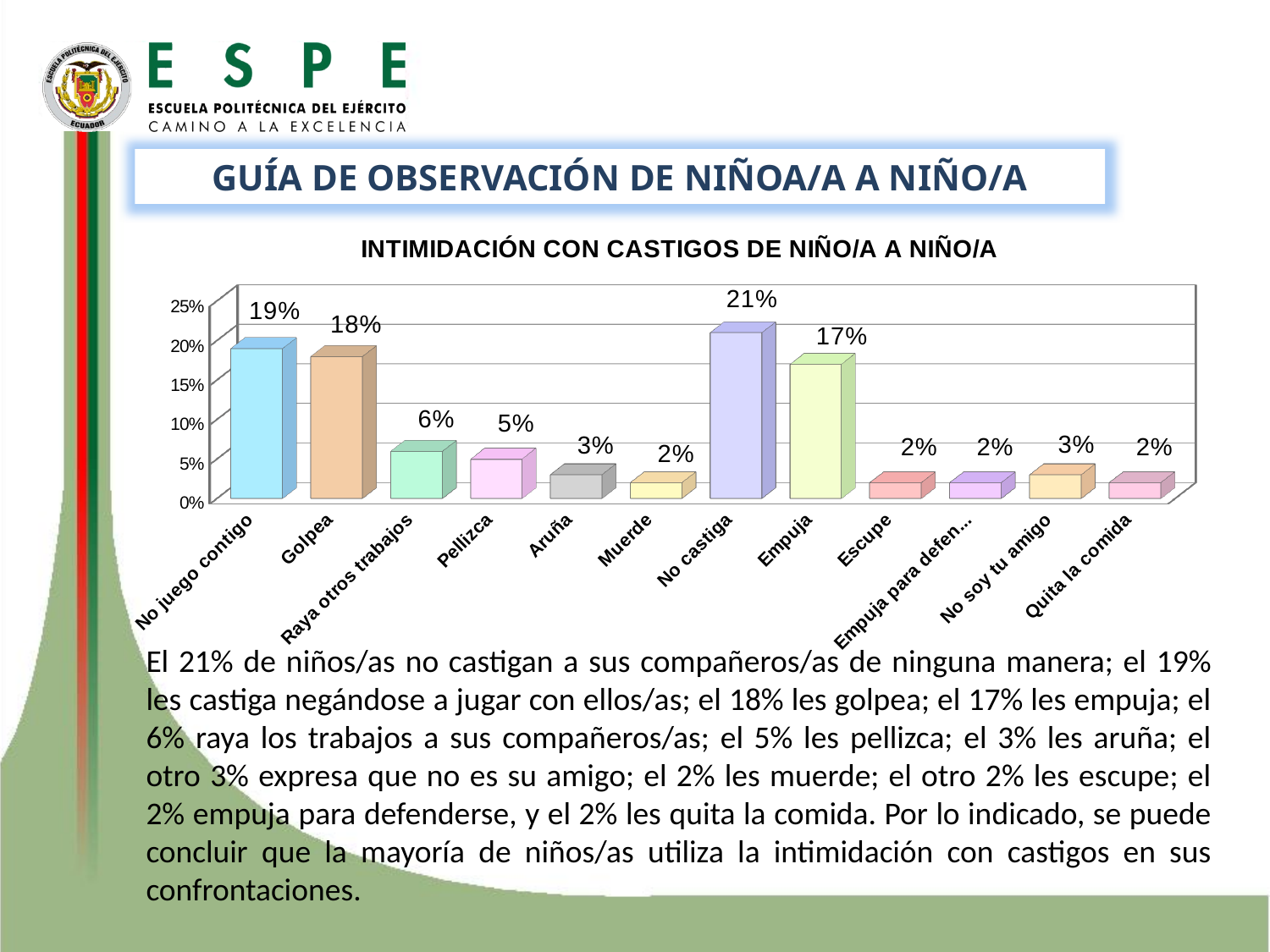
What is the title of the chart? INTIMIDACIÓN CON CASTIGOS DE NIÑO/A A NIÑO/A What is the value for "Raya otros trabajos"? 6% Which is larger, the value for "Golpea" or the value for "Empuja"? Golpea What is the value for "No castiga"? 21% What is the value for "Golpea"? 18% What is the value for "No soy tu amigo"? 3% How many categories are shown on the x axis? 12 What is the difference between the values for "No castiga" and "Pellizca"? 16% Is the value for "No juego contigo" greater or less than 15%? greater What is the difference between the values for "No juego contigo" and "Empuja"? 2% What kind of chart is shown on the slide? Bar chart Which category has the highest value? No castiga